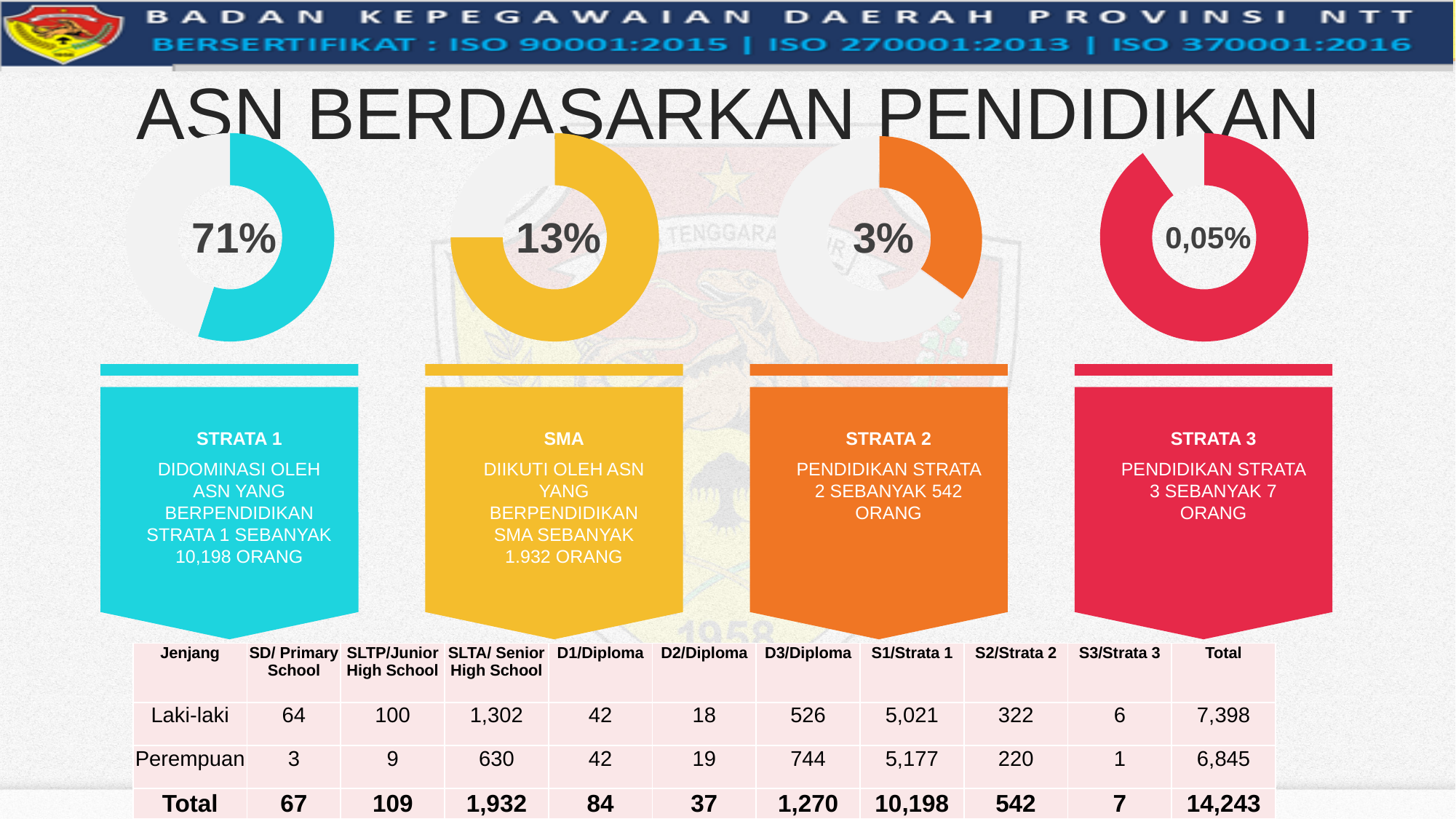
What kind of chart is used to show the percentages on the slide? Donut chart Which education level's donut chart shows the highest percentage? Strata 1 What is the difference between the percentage in the Strata 1 donut chart and the percentage in the SMA donut chart? 58% What percentage is shown in the donut chart above the SMA panel? 13% Which education level's donut chart shows the lowest percentage? Strata 3 How many donut charts are shown on the slide? 4 What colour is the donut chart showing 71%? Cyan What percentage is shown in the leftmost donut chart (Strata 1)? 71% What percentage is shown in the rightmost donut chart (Strata 3)? 0,05% What percentage is shown in the donut chart above the Strata 2 panel? 3% Which is larger, the percentage in the SMA donut chart or the percentage in the Strata 2 donut chart? SMA What colour is the donut chart above the Strata 2 panel? Orange